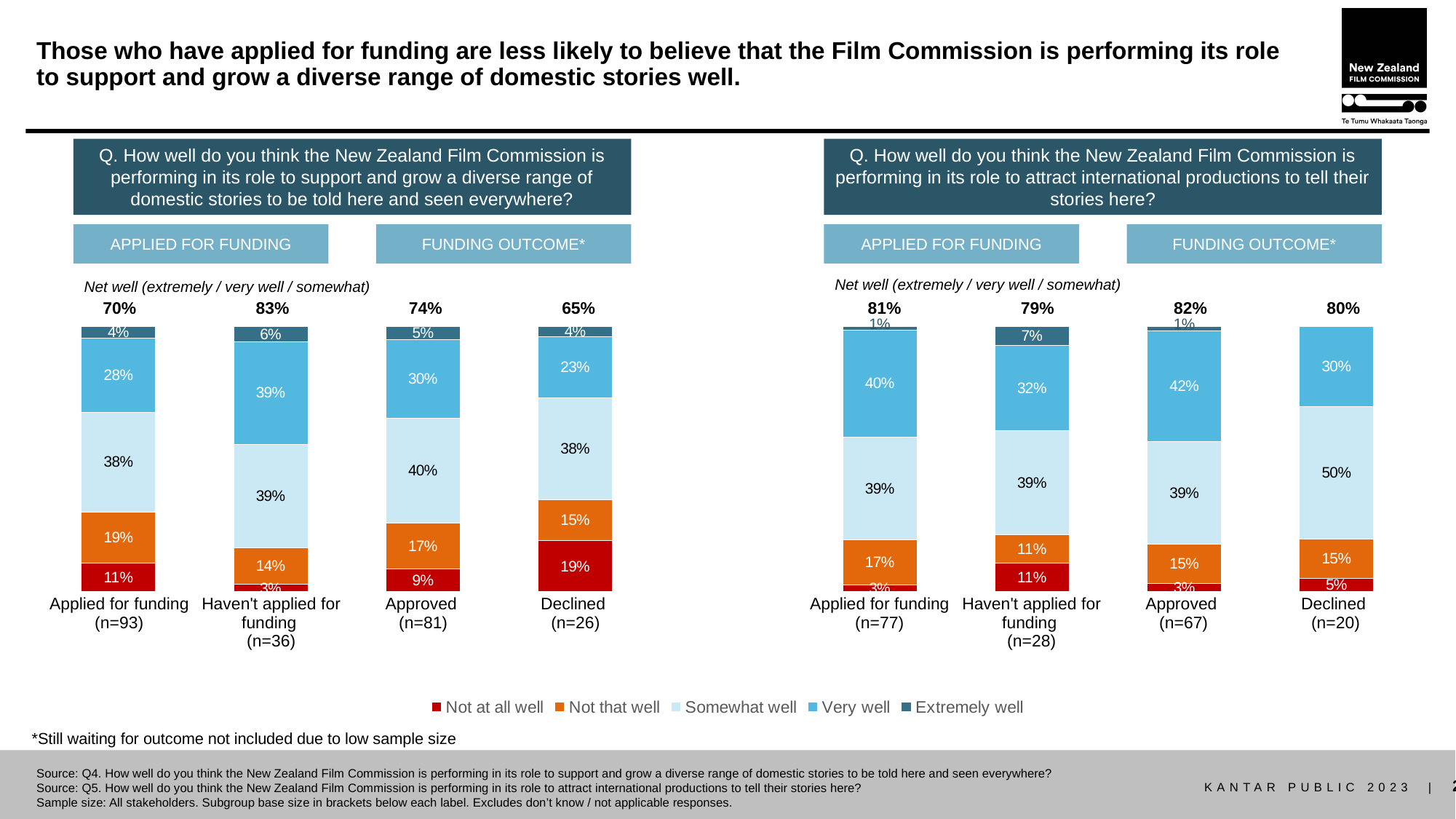
What is the sample size for the Declined group in the right chart (international productions)? n=20 In the left chart (domestic stories), which is larger: the 'Very well' share for Applied for funding or for Haven't applied for funding? Haven't applied for funding In the left chart (domestic stories), which group has the highest Net well percentage? Haven't applied for funding In the right chart (international productions), what is the difference between the Net well percentages for Approved and Haven't applied for funding? 3% What type of chart is used on this slide? Stacked bar chart How many groups (bars) are shown in the left chart (domestic stories)? 4 In the right chart (international productions), what percentage of the Approved group said 'Very well'? 42% How many response categories does the legend list? 5 In the left chart (domestic stories), what is the 'Not at all well' percentage for the Declined group? 19% In the left chart (domestic stories), what percentage of those who applied for funding said 'Somewhat well'? 38% In the right chart (international productions), what percentage of the Declined group said 'Somewhat well'? 50% In the left chart (domestic stories), which group has the lowest Net well percentage? Declined